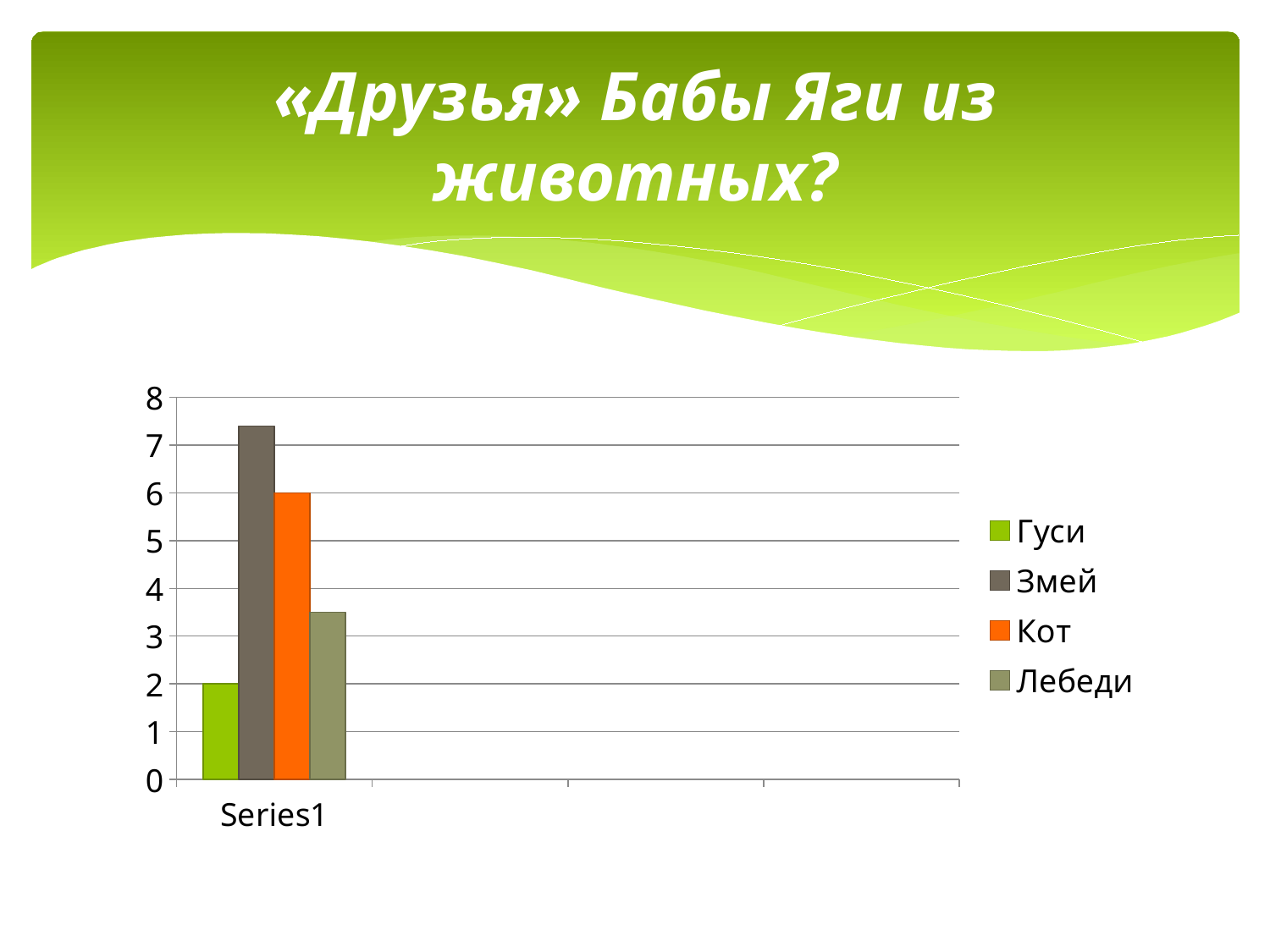
What kind of chart is shown on the slide? bar chart Is the value for Змей greater or less than 7? greater What colour is the bar for Кот? orange What is the difference between the value for Кот and the value for Гуси? 4 Which is larger, the value for Кот or the value for Лебеди? Кот What is the value for Гуси? 2 Which series has the lowest bar? Гуси Which series has the highest bar? Змей Is the value for Лебеди greater or less than 4? less Is the value for Лебеди greater or less than 3? greater How many series does the legend list? 4 What is the value for Кот? 6